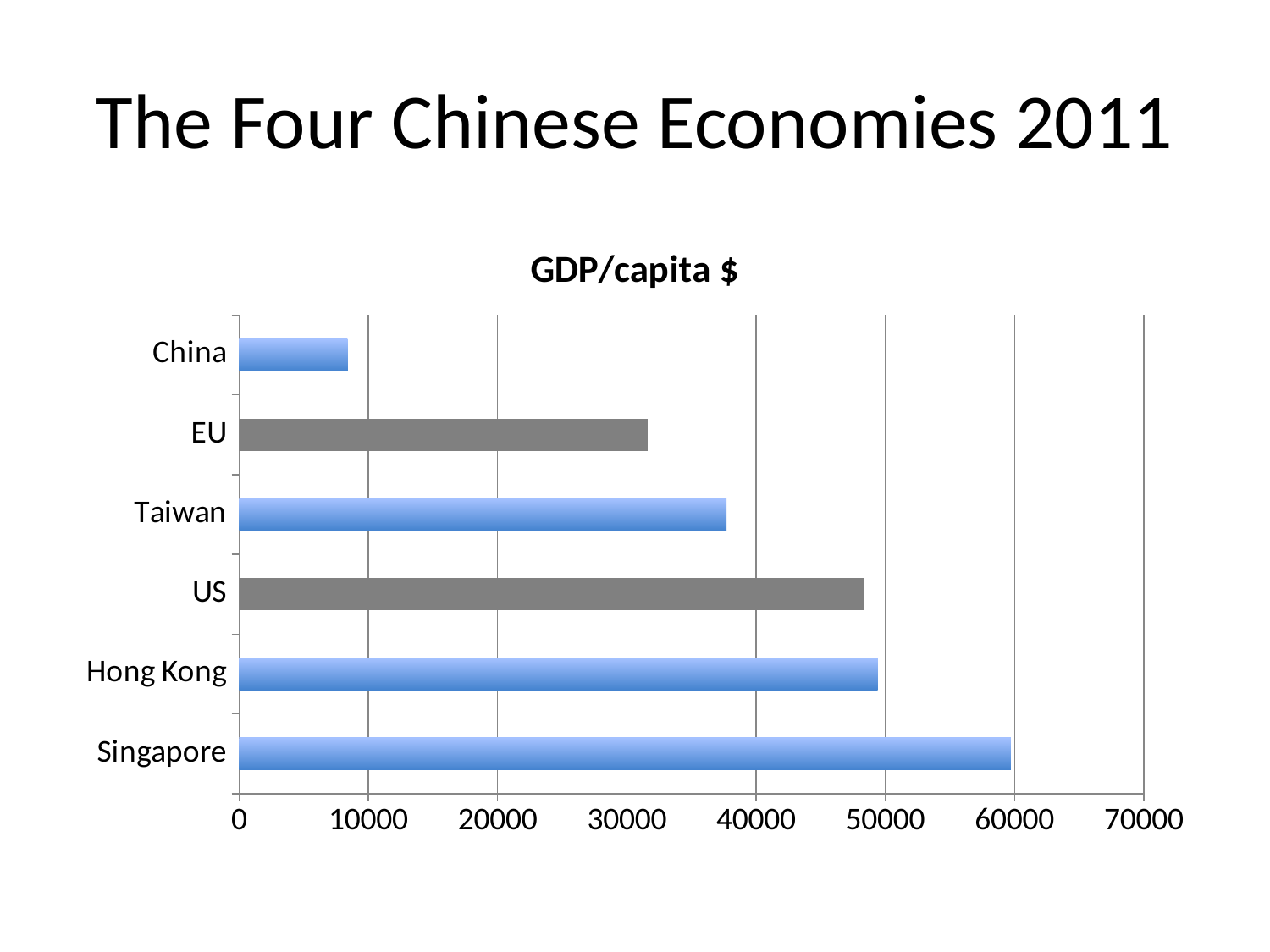
Is the value for Taiwan greater or less than 40000? less How many economies are plotted in the chart? 6 Is the value for Singapore greater or less than 50000? greater What is the title of the chart? GDP/capita $ What kind of chart is shown on the slide? bar chart Is the value for EU greater or less than 30000? greater Which bars in the chart are coloured grey rather than blue? EU and US Which economy has the lowest GDP/capita in the chart? China Which economy has the highest GDP/capita in the chart? Singapore Which has the larger GDP/capita, Taiwan or EU? Taiwan